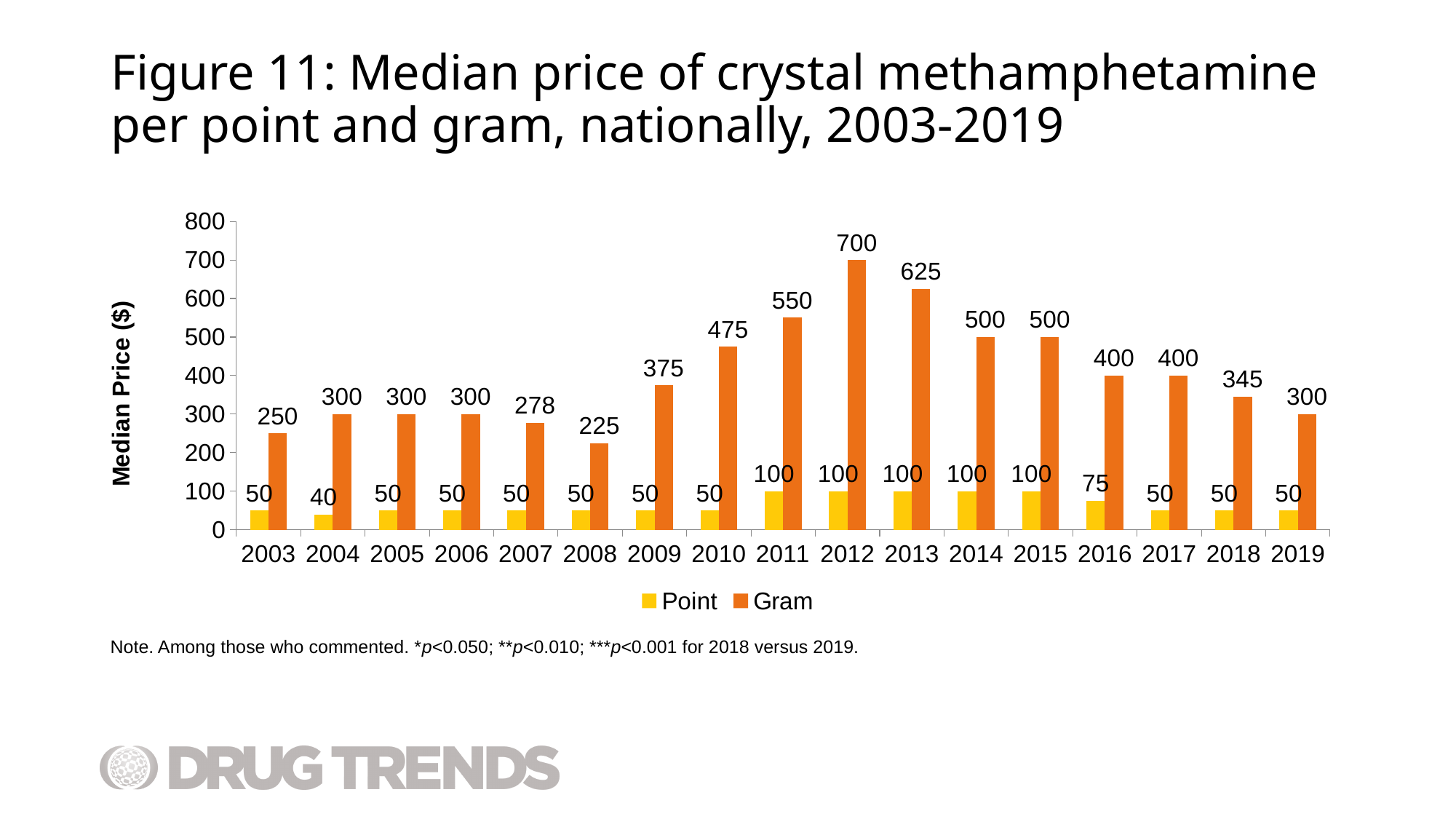
What kind of chart is shown? Bar chart What is the difference between the median price per gram in 2013 and in 2019? 325 How many years are shown on the x axis? 17 Does the median price per gram rise or fall from 2013 to 2019? Fall What is the median price per point in 2004? 40 What is the median price per gram in 2012? 700 How many series does the legend list? 2 What is the median price per gram in 2018? 345 What is the label of the y axis? Median Price ($) Which is larger, the median price per gram in 2009 or in 2017? 2017 In which year is the median price per gram highest? 2012 In which year is the median price per gram lowest? 2008